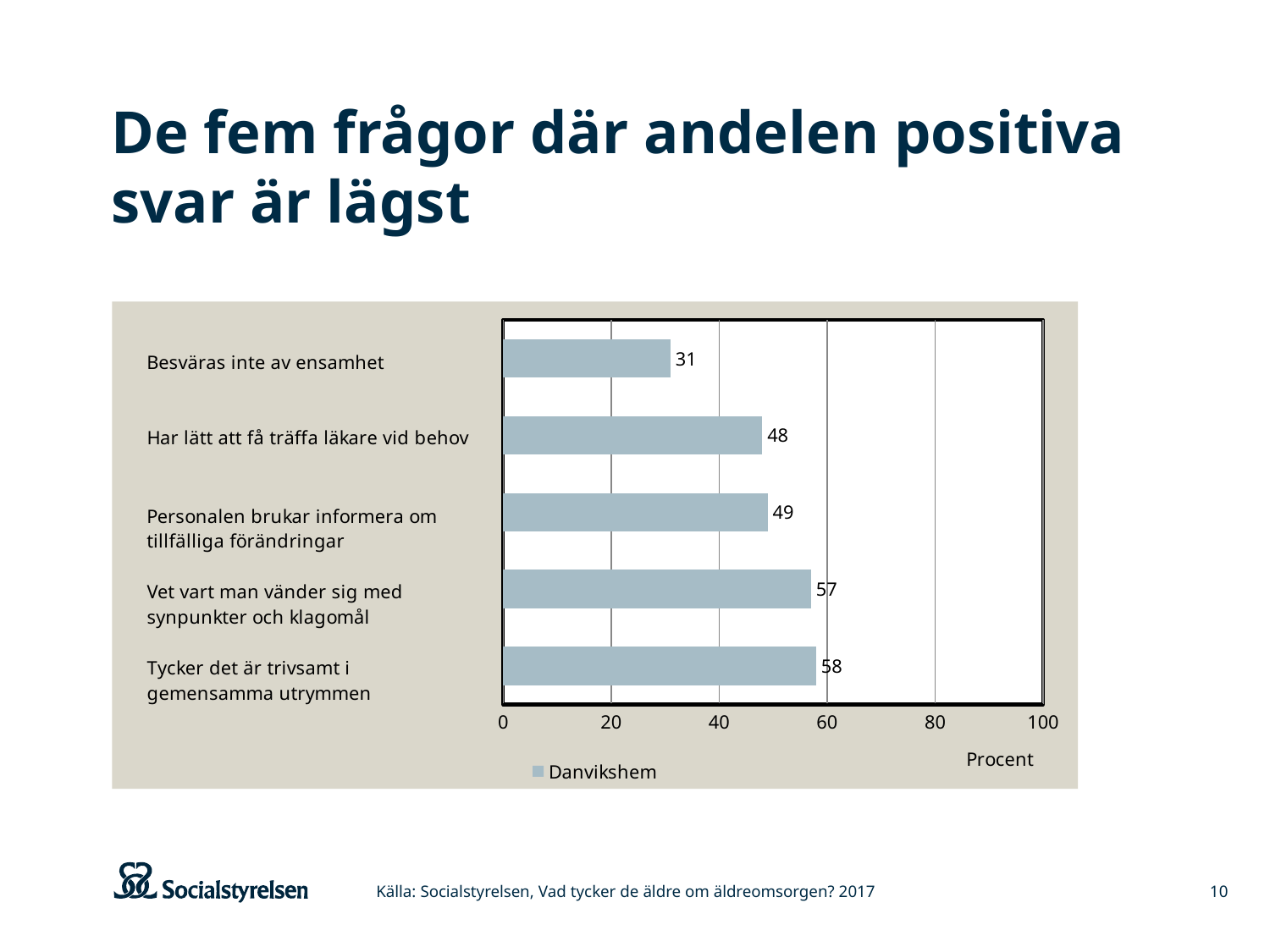
Which category has the lowest value? Besväras inte av ensamhet Is the value for "Har lätt att få träffa läkare vid behov" greater or less than 60? less What is the difference between the values for "Vet vart man vänder sig med synpunkter och klagomål" and "Besväras inte av ensamhet"? 26 How many categories are shown in the chart? 5 How many series does the legend list? 1 What kind of chart is shown on the slide? bar chart What is the value for "Tycker det är trivsamt i gemensamma utrymmen"? 58 What is the name of the series in the legend? Danvikshem What is the value for "Besväras inte av ensamhet"? 31 Which category has the highest value? Tycker det är trivsamt i gemensamma utrymmen Which is larger: the value for "Personalen brukar informera om tillfälliga förändringar" or the value for "Besväras inte av ensamhet"? Personalen brukar informera om tillfälliga förändringar What is the value for "Har lätt att få träffa läkare vid behov"? 48